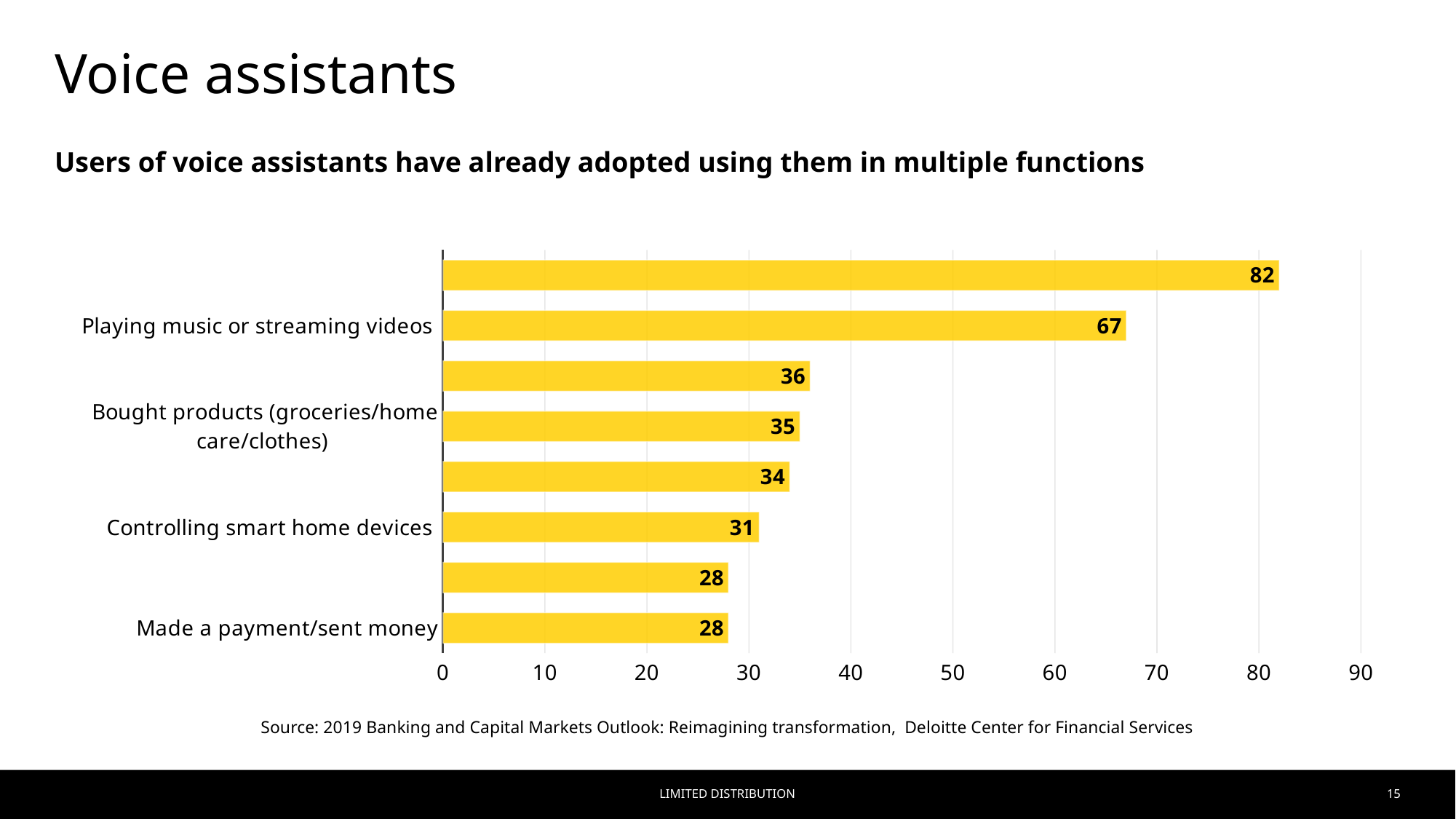
What value is shown for "Playing music or streaming videos"? 67 Which has a larger value: "Playing music or streaming videos" or "Controlling smart home devices"? Playing music or streaming videos Is the value for "Controlling smart home devices" greater or less than 30? greater What is the difference between the values for "Controlling smart home devices" and "Made a payment/sent money"? 3 What kind of chart is shown on the slide? Bar chart What is the largest value labelled on any bar in the chart? 82 What value is shown for "Controlling smart home devices"? 31 What value is shown for "Made a payment/sent money"? 28 What colour are the bars in the chart? Yellow What is the difference between the values for "Playing music or streaming videos" and "Bought products (groceries/home care/clothes)"? 32 How many bars are plotted in the chart? 8 What value is shown for "Bought products (groceries/home care/clothes)"? 35